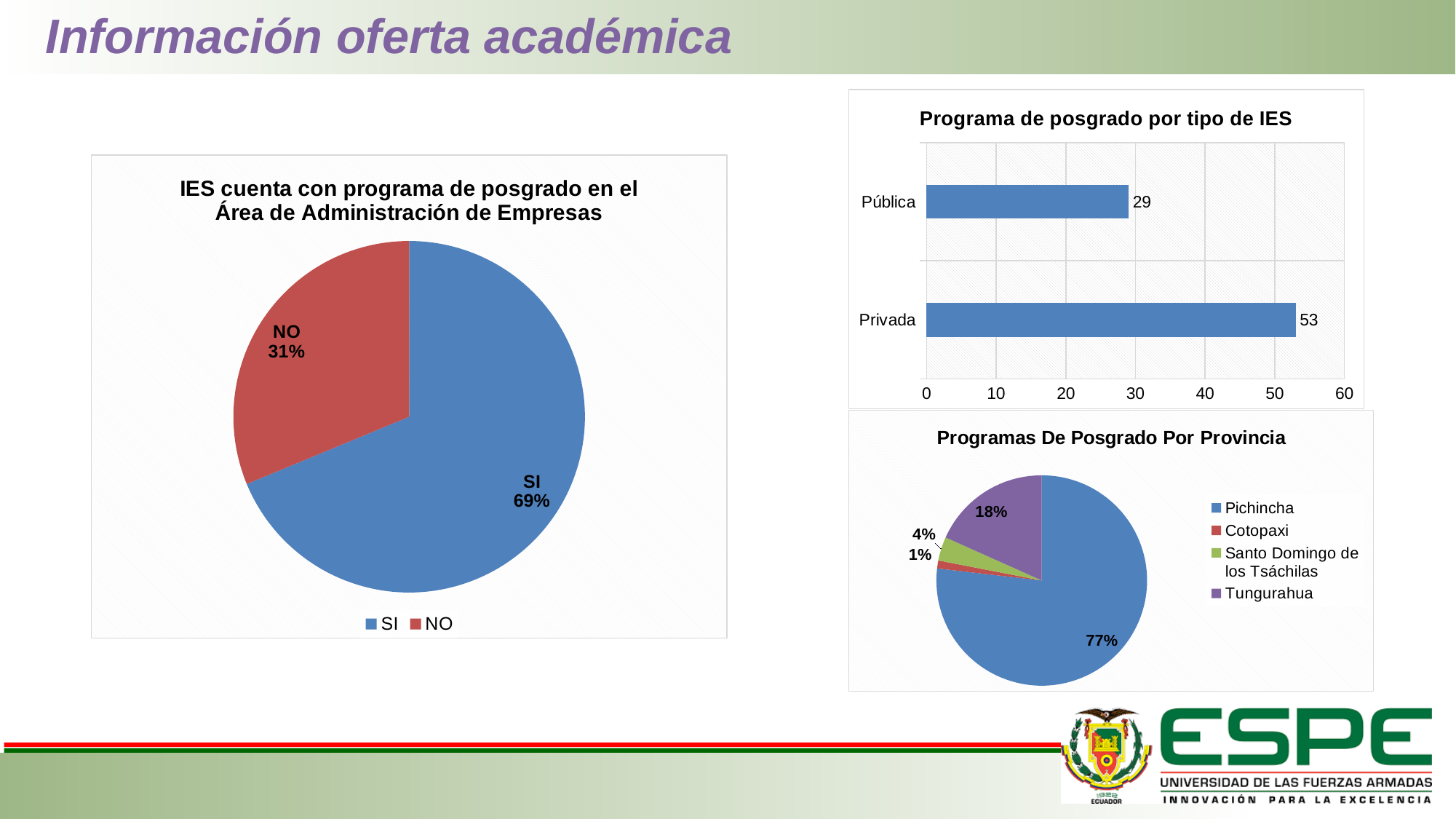
In the chart titled "Programas De Posgrado Por Provincia", which province has the smallest share? Cotopaxi In the chart titled "Programas De Posgrado Por Provincia", what share does Pichincha have? 77% In the chart titled "Programas De Posgrado Por Provincia", what share does Tungurahua have? 18% In the chart titled "IES cuenta con programa de posgrado en el Área de Administración de Empresas", what share does SI have? 69% In the chart titled "Programa de posgrado por tipo de IES", what is the difference between Privada and Pública? 24 In the chart titled "Programa de posgrado por tipo de IES", what is the value for Privada? 53 How many provinces does the legend of "Programas De Posgrado Por Provincia" list? 4 What kind of chart is "IES cuenta con programa de posgrado en el Área de Administración de Empresas"? Pie chart In the chart titled "Programa de posgrado por tipo de IES", what is the value for Pública? 29 What kind of chart is "Programa de posgrado por tipo de IES"? Bar chart In the chart titled "Programa de posgrado por tipo de IES", which category has the higher value? Privada